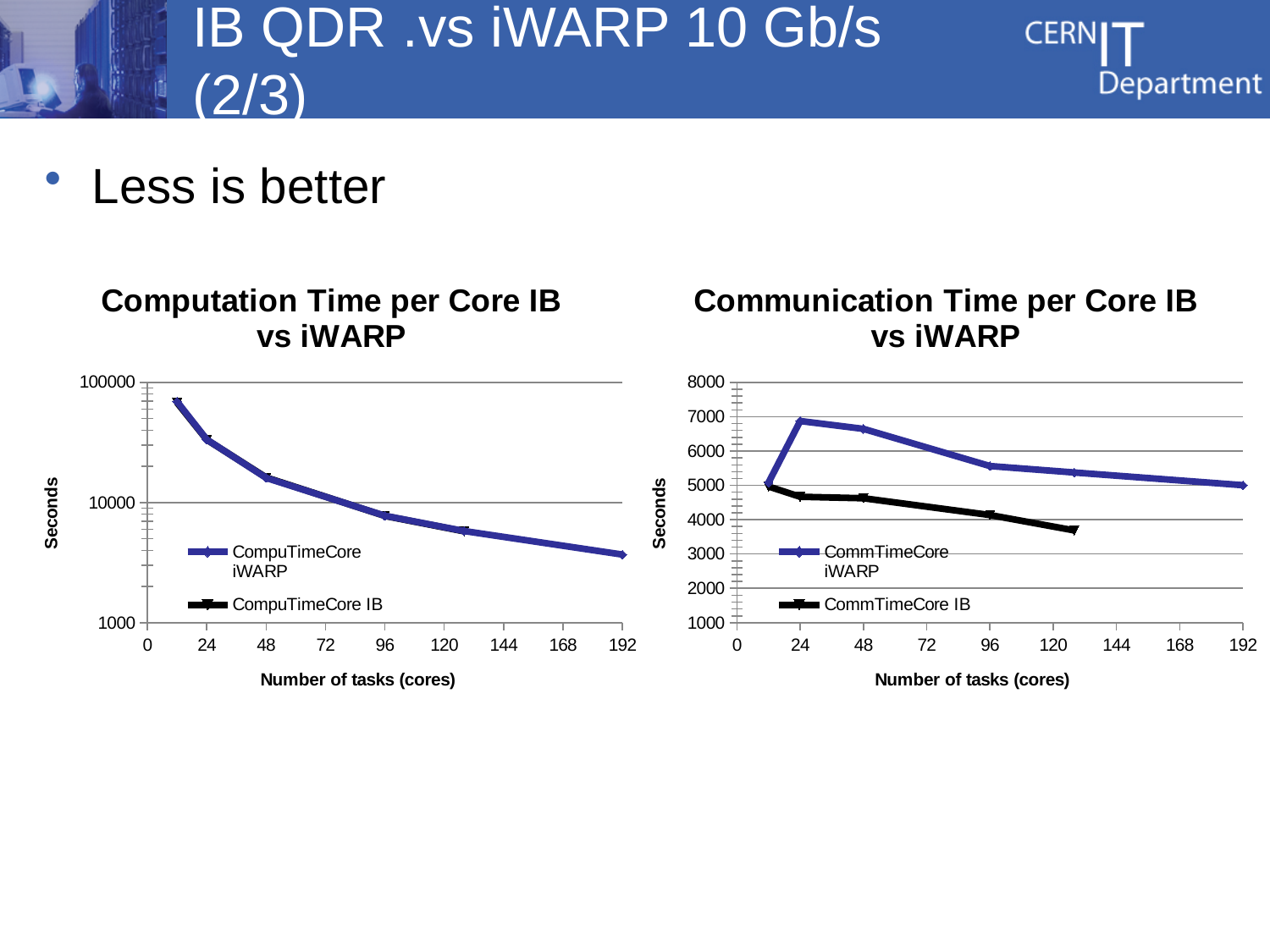
In the "Computation Time per Core IB vs iWARP" chart, do the values rise or fall as the number of tasks increases? fall What kind of chart is the "Computation Time per Core IB vs iWARP" chart? line chart How many series does the legend of the "Communication Time per Core IB vs iWARP" chart list? 2 In the "Communication Time per Core IB vs iWARP" chart, is the CommTimeCore IB value at 24 tasks greater or less than 5000? less How many series does the legend of the "Computation Time per Core IB vs iWARP" chart list? 2 In the "Communication Time per Core IB vs iWARP" chart, does the CommTimeCore IB series rise or fall as the number of tasks increases from 24 to 128? fall In the "Communication Time per Core IB vs iWARP" chart, which series has the larger value at 96 tasks, CommTimeCore iWARP or CommTimeCore IB? CommTimeCore iWARP What kind of chart is the "Communication Time per Core IB vs iWARP" chart? line chart In the "Communication Time per Core IB vs iWARP" chart, is the CommTimeCore IB value at 128 tasks greater or less than 4000? less What is the x-axis label of the "Communication Time per Core IB vs iWARP" chart? Number of tasks (cores) In the "Communication Time per Core IB vs iWARP" chart, is the CommTimeCore iWARP value at 24 tasks greater or less than 6000? greater